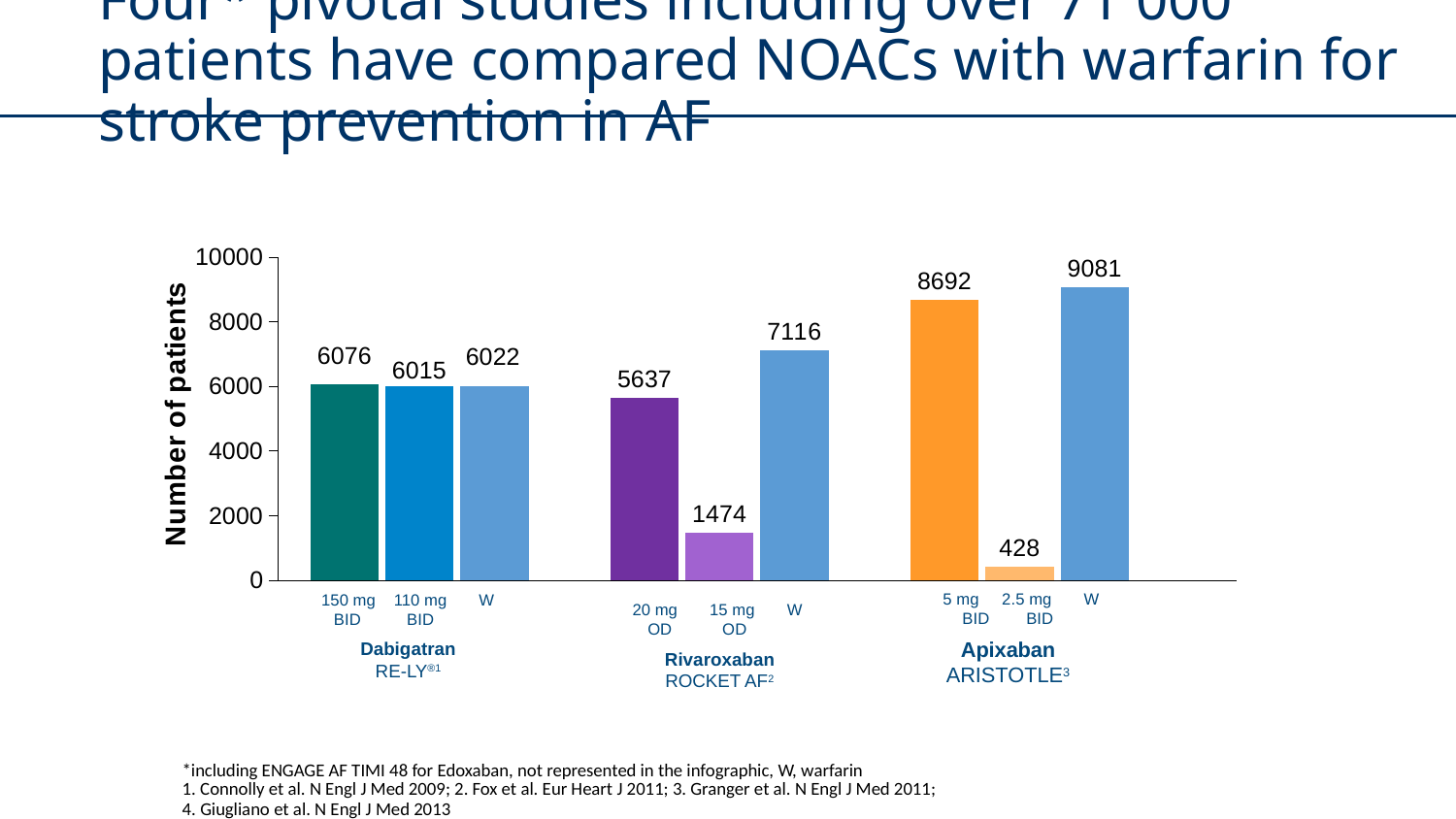
Which bar shows the highest number of patients? W (warfarin) in ARISTOTLE, 9081 How many patients received rivaroxaban 15 mg OD in ROCKET AF? 1474 How many bars are plotted in the chart? 9 What type of chart is shown on the slide? Bar chart What is the label of the y-axis? Number of patients What is the total number of patients across the three arms of the RE-LY trial? 18113 Is the number of patients for dabigatran 110 mg BID greater or less than 4000? greater Which bar shows the lowest number of patients? Apixaban 2.5 mg BID, 428 Which had more patients: apixaban 5 mg BID or rivaroxaban 20 mg OD? Apixaban 5 mg BID How many patients received dabigatran 150 mg BID in RE-LY? 6076 How many patients were in the warfarin (W) arm of the ARISTOTLE trial for apixaban? 9081 What is the difference in number of patients between the warfarin arm and the 20 mg OD arm in ROCKET AF? 1479